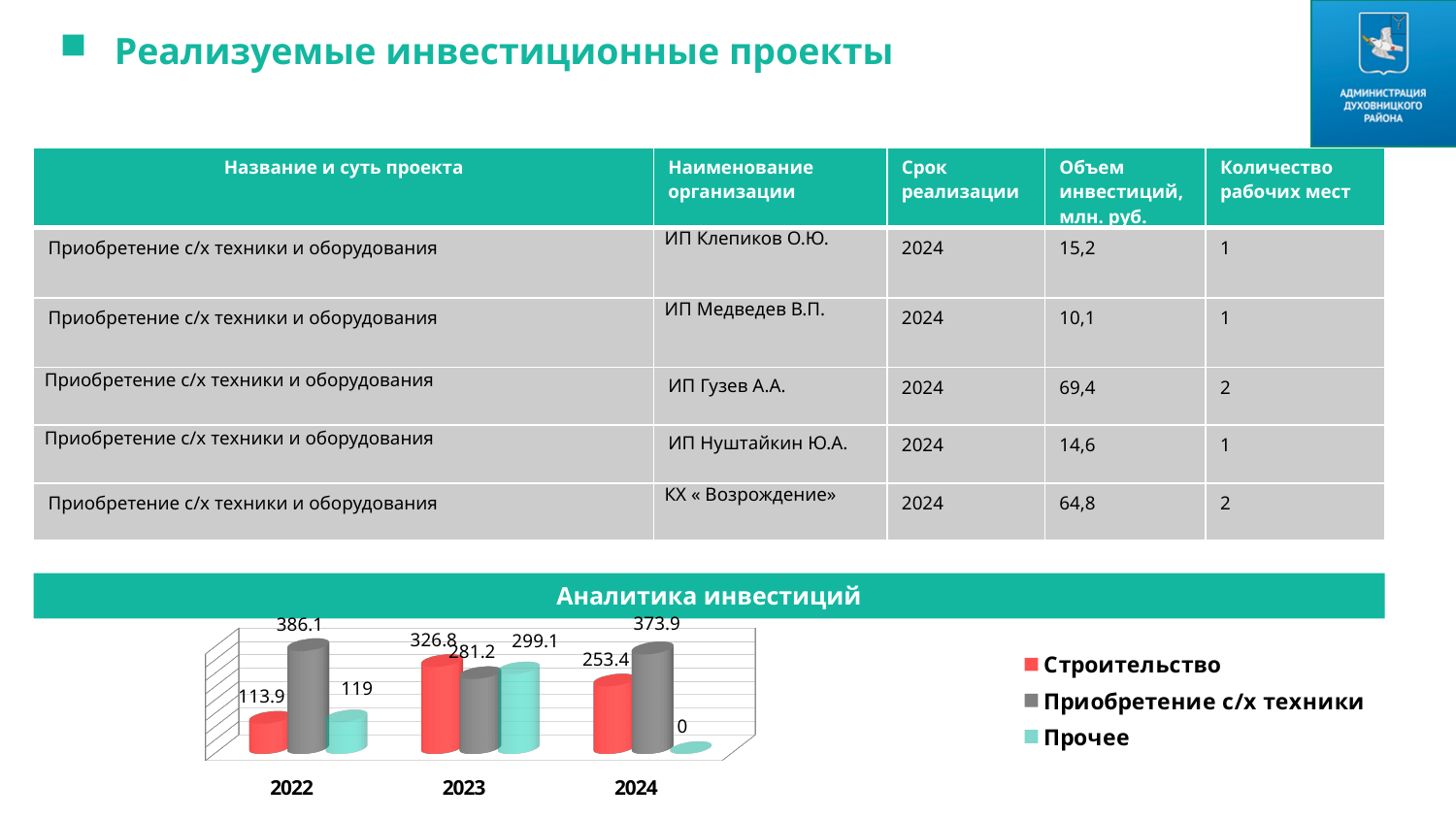
In the 'Аналитика инвестиций' chart, which year has the lowest value for 'Прочее'? 2024 In the 'Аналитика инвестиций' chart, which colour represents the 'Строительство' series? red In the 'Аналитика инвестиций' chart, which year has the highest value for 'Строительство'? 2023 How many years are shown on the x axis of the 'Аналитика инвестиций' chart? 3 How many series does the legend of the 'Аналитика инвестиций' chart list? 3 In the 'Аналитика инвестиций' chart, what is the value for 'Строительство' in 2023? 326.8 In the 'Аналитика инвестиций' chart, which is larger in 2024: 'Строительство' or 'Приобретение с/х техники'? Приобретение с/х техники In the 'Аналитика инвестиций' chart, what is the difference between 'Приобретение с/х техники' and 'Строительство' in 2022? 272.2 What type of chart is shown under the heading 'Аналитика инвестиций'? bar chart In the 'Аналитика инвестиций' chart, what is the value for 'Приобретение с/х техники' in 2022? 386.1 In the 'Аналитика инвестиций' chart, what is the value for 'Прочее' in 2023? 299.1 In the 'Аналитика инвестиций' chart, what is the value for 'Прочее' in 2024? 0